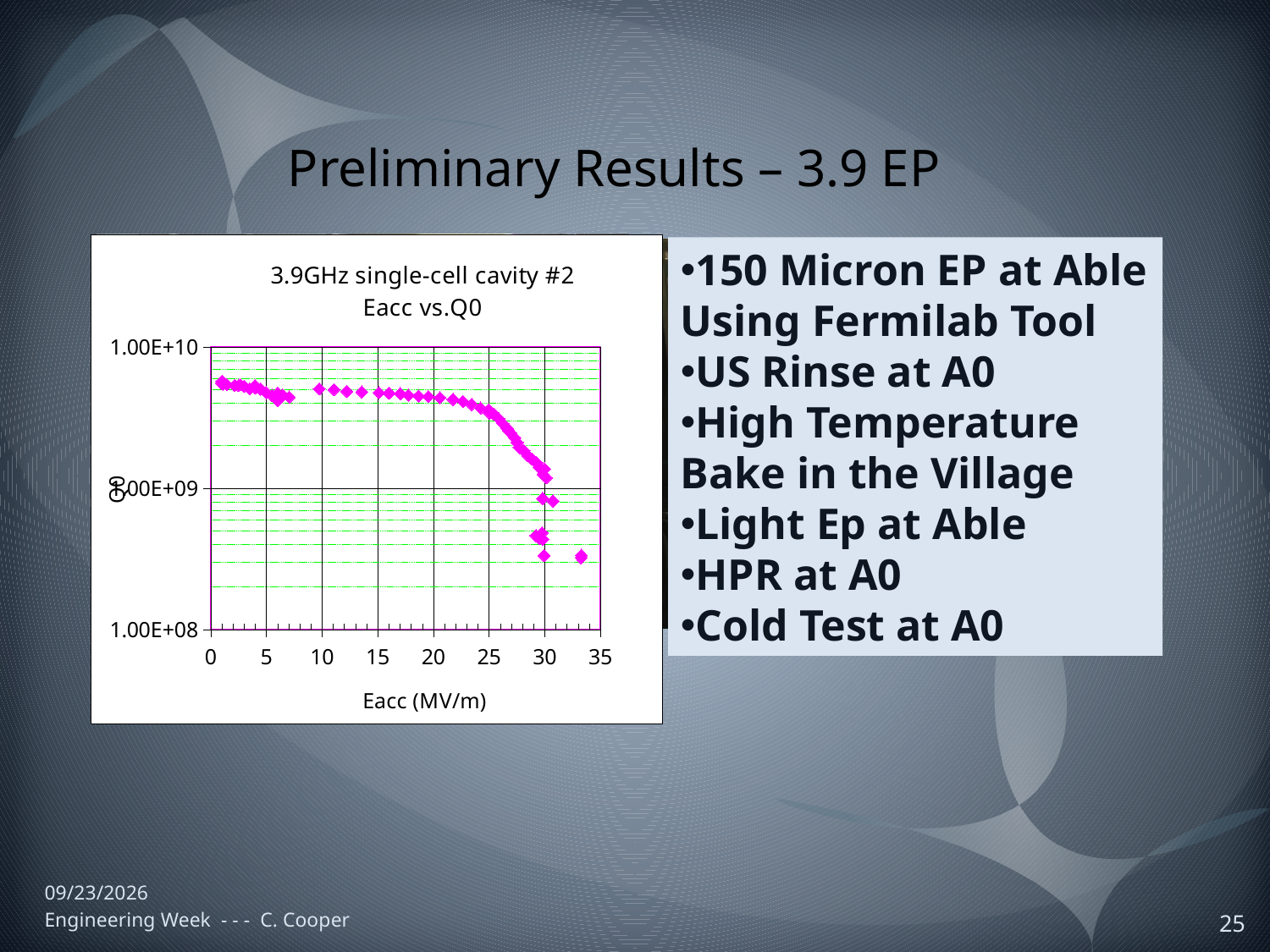
What is the highest value shown on the y axis of the chart? 1.00E+10 What is the largest tick value shown on the x axis of the chart? 35 What is the title of the chart? 3.9GHz single-cell cavity #2 Eacc vs.Q0 Is the Q0 value of the rightmost point (near Eacc of 33 MV/m) greater or less than 1.00E+09? less Is the Q0 value at Eacc of about 25 MV/m greater or less than 1.00E+10? less Do the Q0 values rise or fall as Eacc increases along the x axis? fall What kind of chart is shown on the slide? scatter chart Is the Q0 value at Eacc of about 20 MV/m greater or less than 1.00E+09? greater Which is larger, the Q0 value at Eacc of about 10 MV/m or the Q0 value at Eacc of about 30 MV/m? Eacc of about 10 MV/m